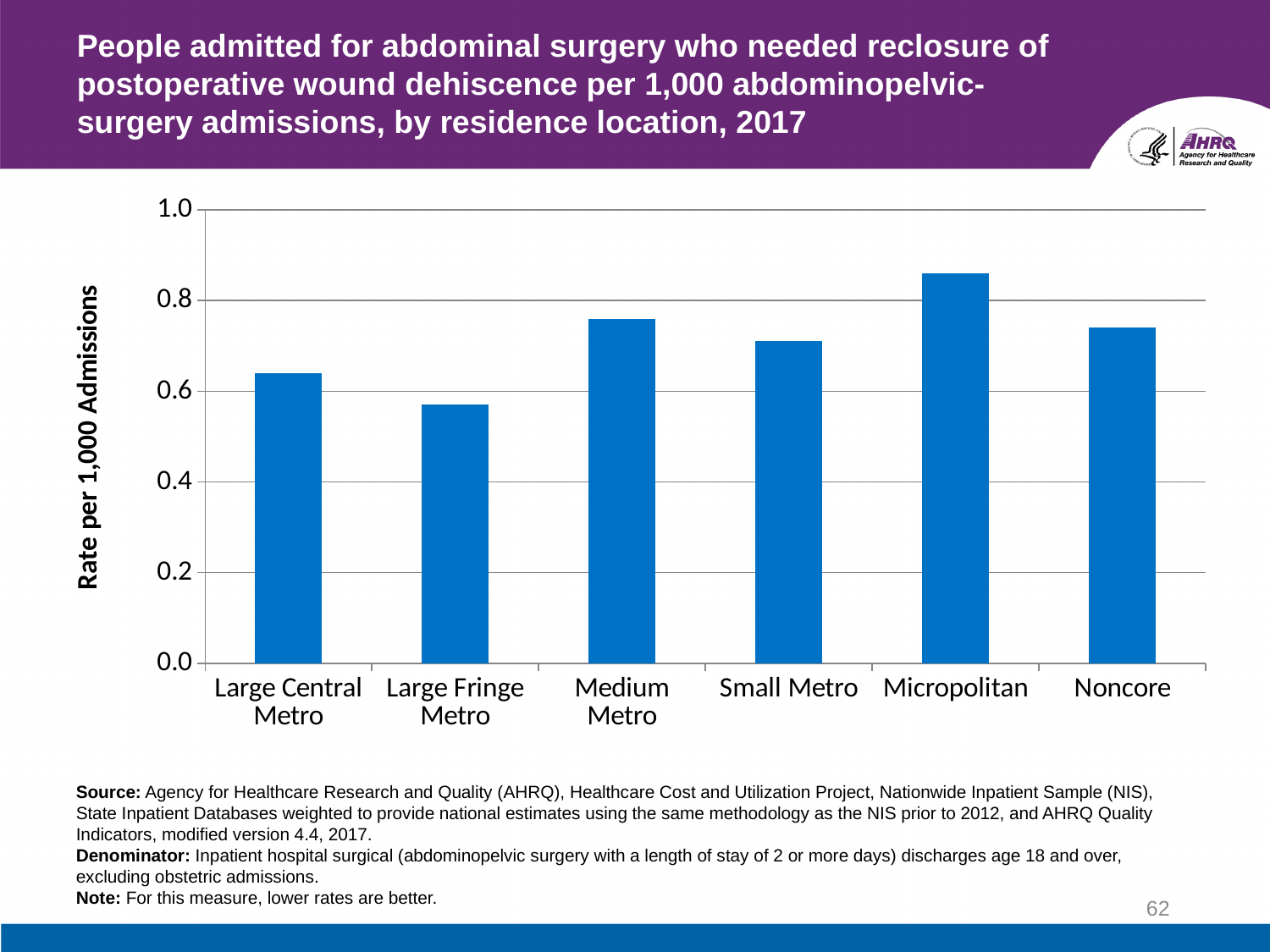
What is the label of the y axis? Rate per 1,000 Admissions Which has a higher rate, Large Fringe Metro or Small Metro? Small Metro Is the value for Large Central Metro greater or less than 0.6? greater Which residence location has the highest rate per 1,000 admissions? Micropolitan How many residence location categories are shown on the x axis? 6 Is the value for Medium Metro greater or less than 0.8? less Is the value for Micropolitan greater or less than 0.8? greater Which has a higher rate, Micropolitan or Large Central Metro? Micropolitan What kind of chart is shown on the slide? Bar chart Which residence location has the lowest rate per 1,000 admissions? Large Fringe Metro